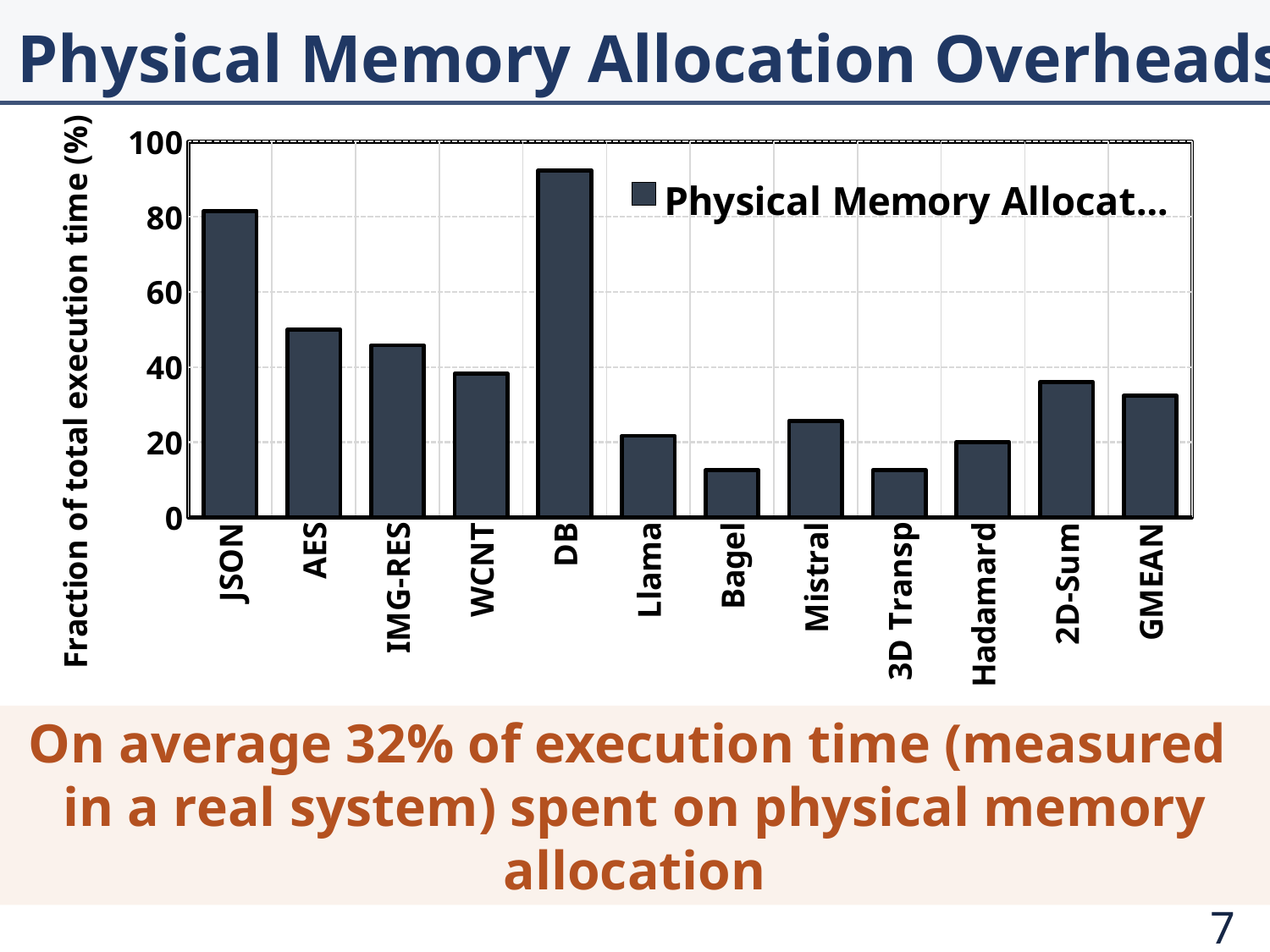
Which category has the highest fraction of total execution time? DB What kind of chart is shown on the slide? bar chart Is the value for Llama greater or less than 40? less Is the value for Bagel greater or less than 20? less Which is larger, the value for JSON or the value for AES? JSON What is the label of the y axis? Fraction of total execution time (%) Is the value for AES greater or less than 40? greater How many categories are shown on the x axis? 12 How many series does the legend list? 1